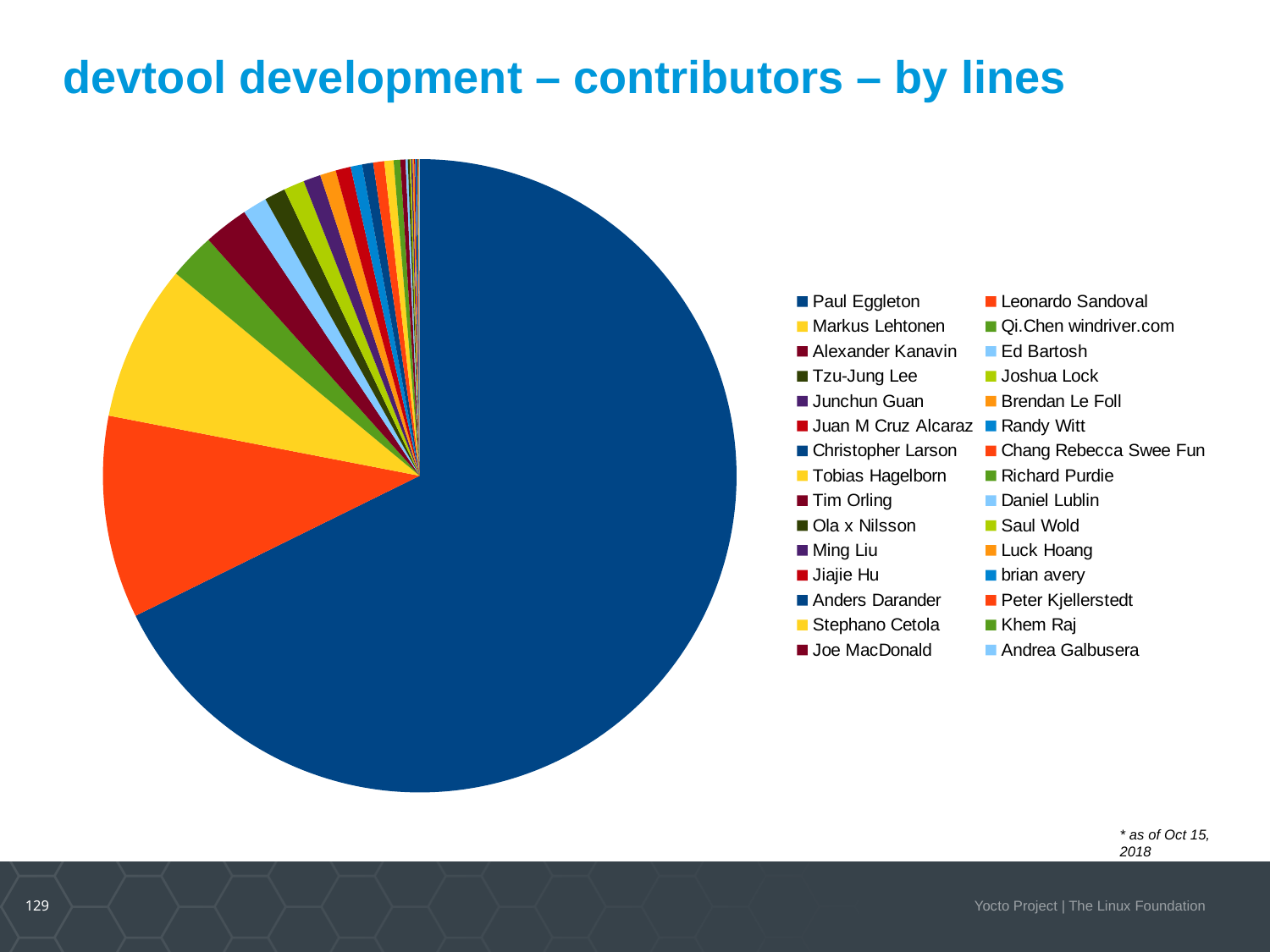
Which contributor has the second-largest slice of the pie? Leonardo Sandoval Which contributor has the largest slice of the pie? Paul Eggleton What kind of chart is shown on the slide? pie chart How many contributors are listed in the legend? 30 Which slice is larger, Leonardo Sandoval's or Markus Lehtonen's? Leonardo Sandoval Which slice is larger, Paul Eggleton's or Leonardo Sandoval's? Paul Eggleton Which slice is larger, Markus Lehtonen's or Ed Bartosh's? Markus Lehtonen Is Paul Eggleton's share of the pie greater or less than half? greater As of what date is the chart data, according to the footnote? Oct 15, 2018 What is the title of the slide? devtool development – contributors – by lines